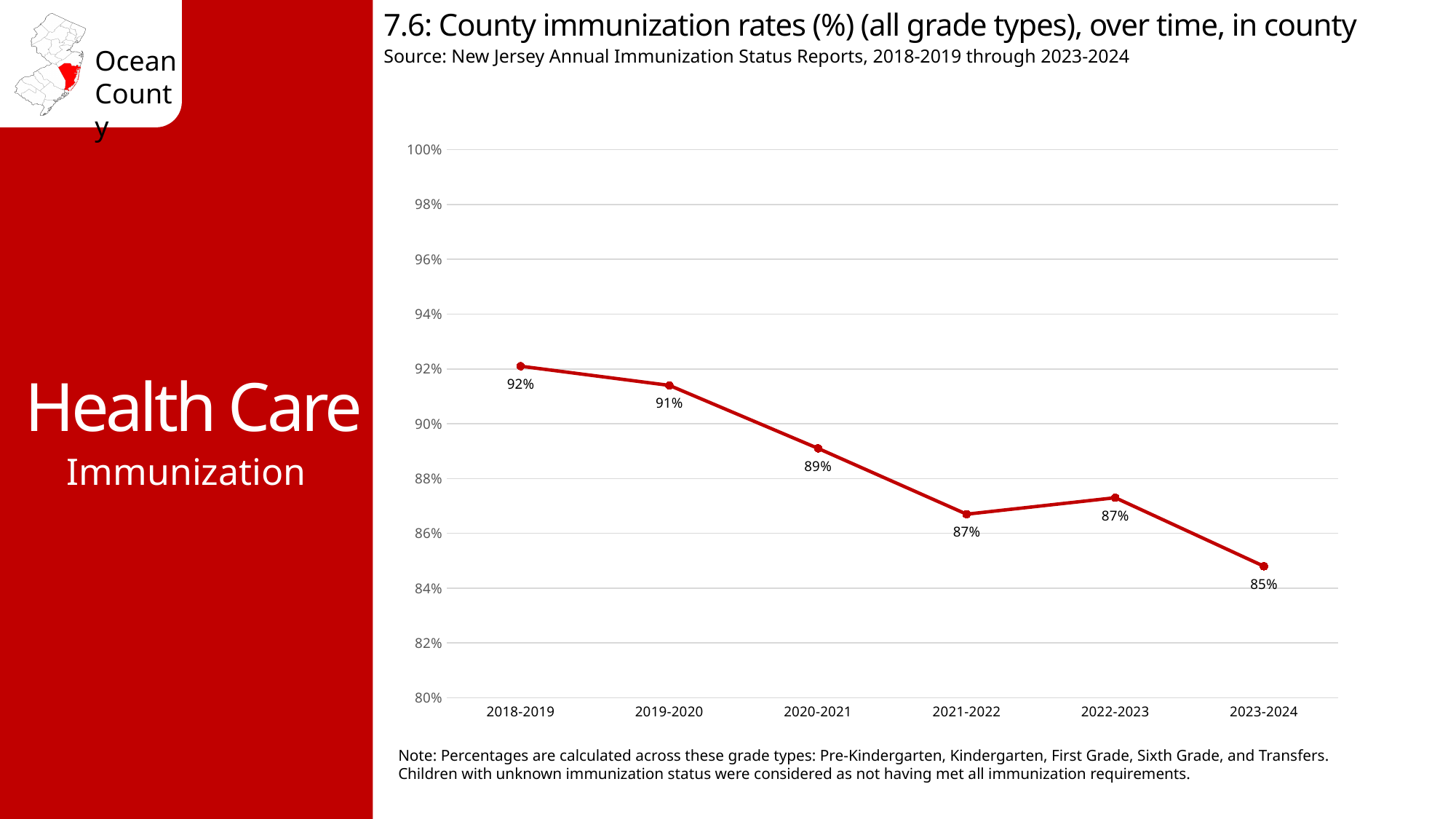
What is the county immunization rate for 2020-2021? 89% What is the county immunization rate for 2018-2019? 92% By how many percentage points does the 2018-2019 rate exceed the 2023-2024 rate? 7 percentage points Is the value for 2023-2024 greater or less than 86%? less What is the county immunization rate for 2019-2020? 91% Do the immunization rates generally rise or fall from 2018-2019 to 2023-2024? Fall How many school years are plotted on the chart? 6 Which school year has the lowest immunization rate? 2023-2024 Which school year has the highest immunization rate? 2018-2019 What kind of chart is shown on the slide? Line chart What is the county immunization rate for 2023-2024? 85% Which is larger, the immunization rate for 2019-2020 or for 2021-2022? 2019-2020